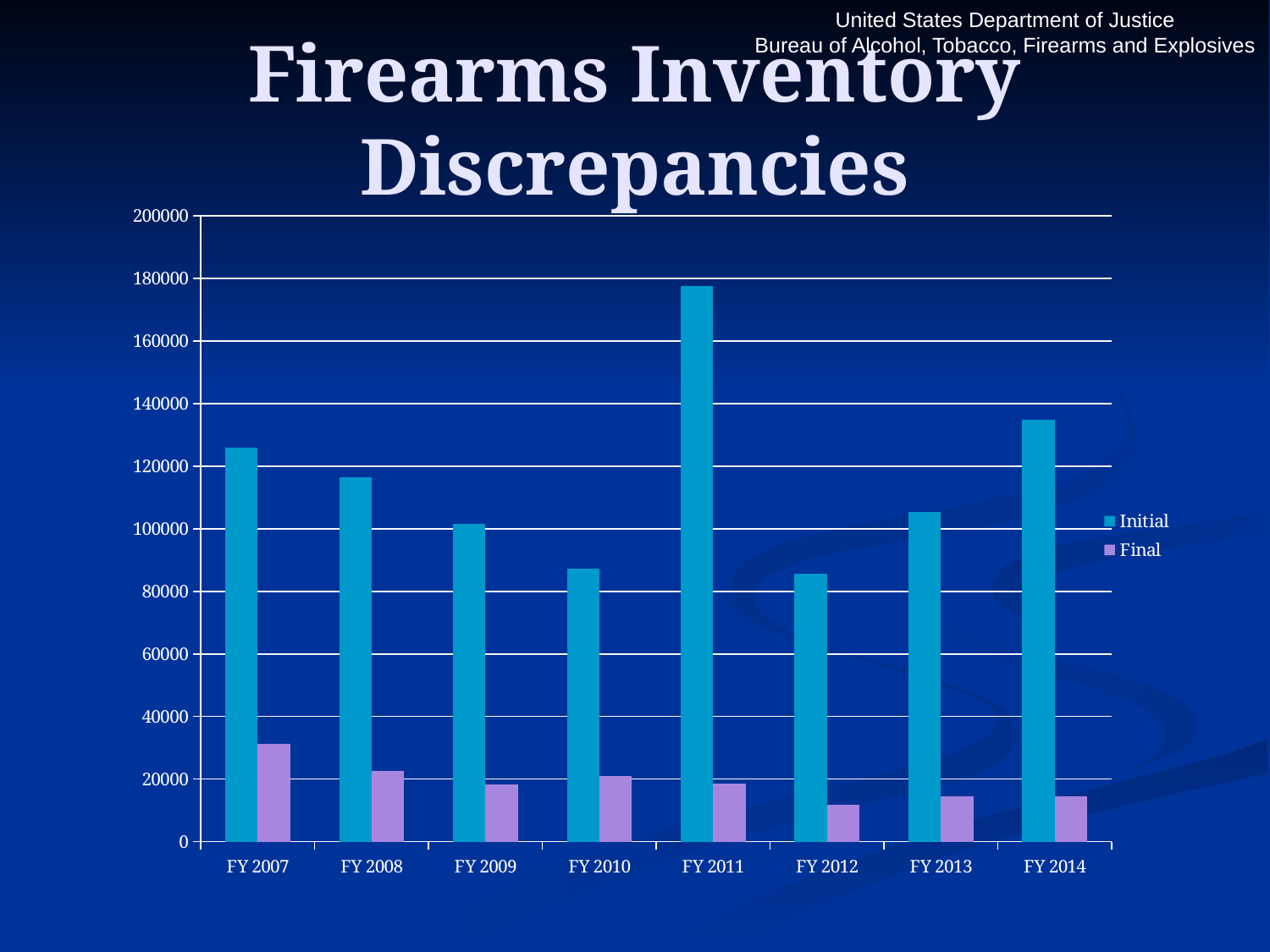
How many fiscal years are shown on the x axis of the chart? 8 Which fiscal year has the highest Final value? FY 2007 What kind of chart is shown on the slide? bar chart Is the Final value for FY 2007 greater or less than 20000? greater Which fiscal year has the highest Initial value? FY 2011 Is the Initial value for FY 2014 greater or less than 120000? greater How many series does the chart's legend list? 2 Which is larger, the Initial value for FY 2013 or the Initial value for FY 2014? FY 2014 Does the Initial value rise or fall from FY 2011 to FY 2012? fall What are the two series named in the chart's legend? Initial and Final Is the Initial value for FY 2011 greater or less than 160000? greater